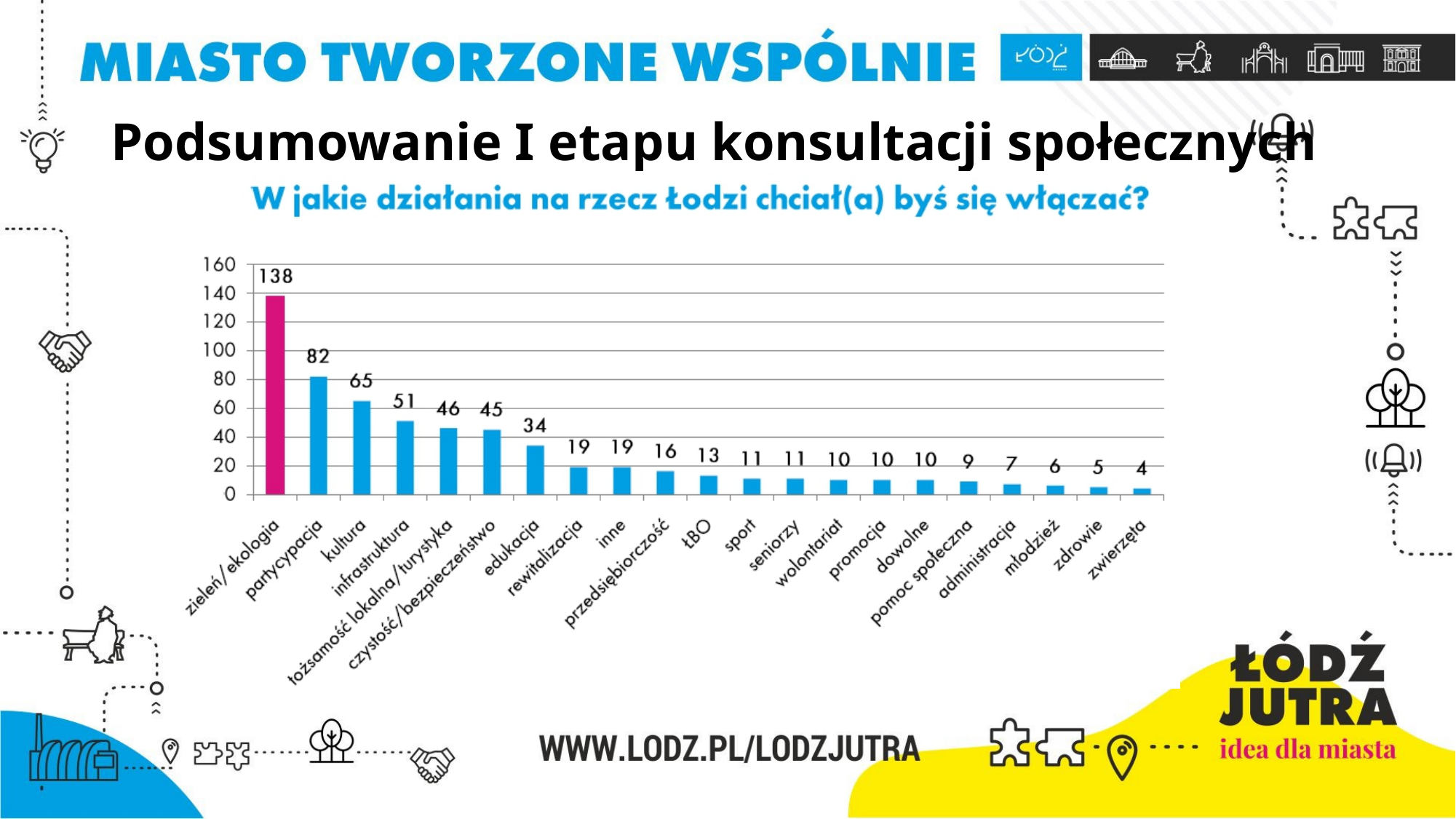
Which category has the lowest value? zwierzęta What type of chart is shown on the slide? bar chart What is the value for przedsiębiorczość? 16 Which is larger, the value for infrastruktura or the value for czystość/bezpieczeństwo? infrastruktura Do the values rise or fall moving from left to right along the x axis? fall What is the value for kultura? 65 What is the value for zieleń/ekologia? 138 What is the difference between the values for zieleń/ekologia and partycypacja? 56 Which category has the highest value? zieleń/ekologia How many categories are shown on the x axis? 21 What is the title of the chart? W jakie działania na rzecz Łodzi chciał(a) byś się włączać? What is the value for edukacja? 34